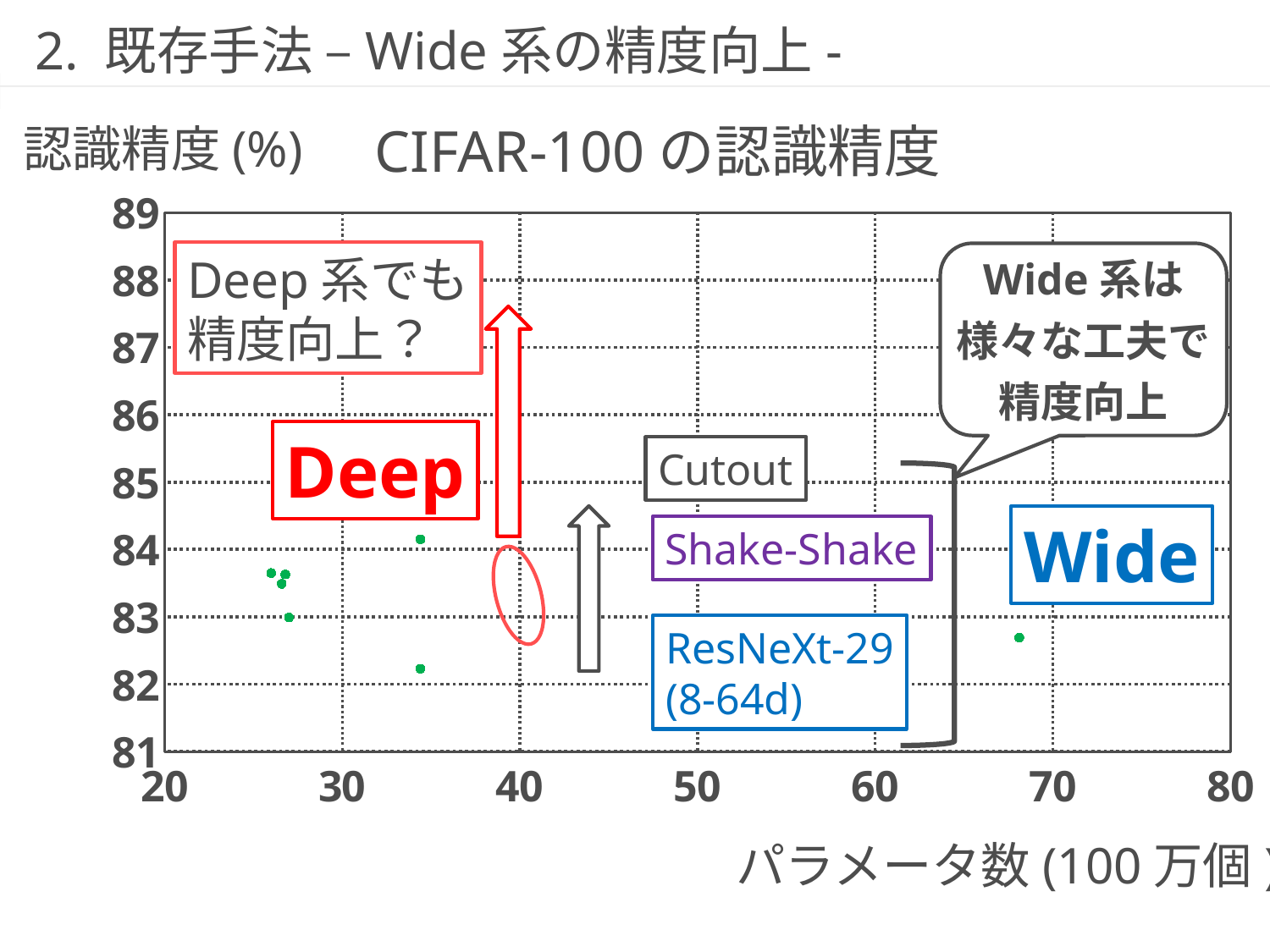
What is the label of the x axis? パラメータ数 (100 万個) Is the accuracy of the highest plotted point greater or less than 84? greater Which has the higher accuracy: the rightmost point (around 68 on the x axis) or the cluster of points near 26-27 on the x axis? the cluster near 26-27 What is the title of the chart? CIFAR-100 の認識精度 What kind of chart is shown on the slide? scatter plot Is the parameter count of the rightmost point greater or less than 60? greater Is the accuracy of the point with the largest parameter count (around 68) greater or less than 83? less How many data points are plotted on the chart? 7 Are the points with parameter counts below 40 labelled as the Deep group or the Wide group? Deep